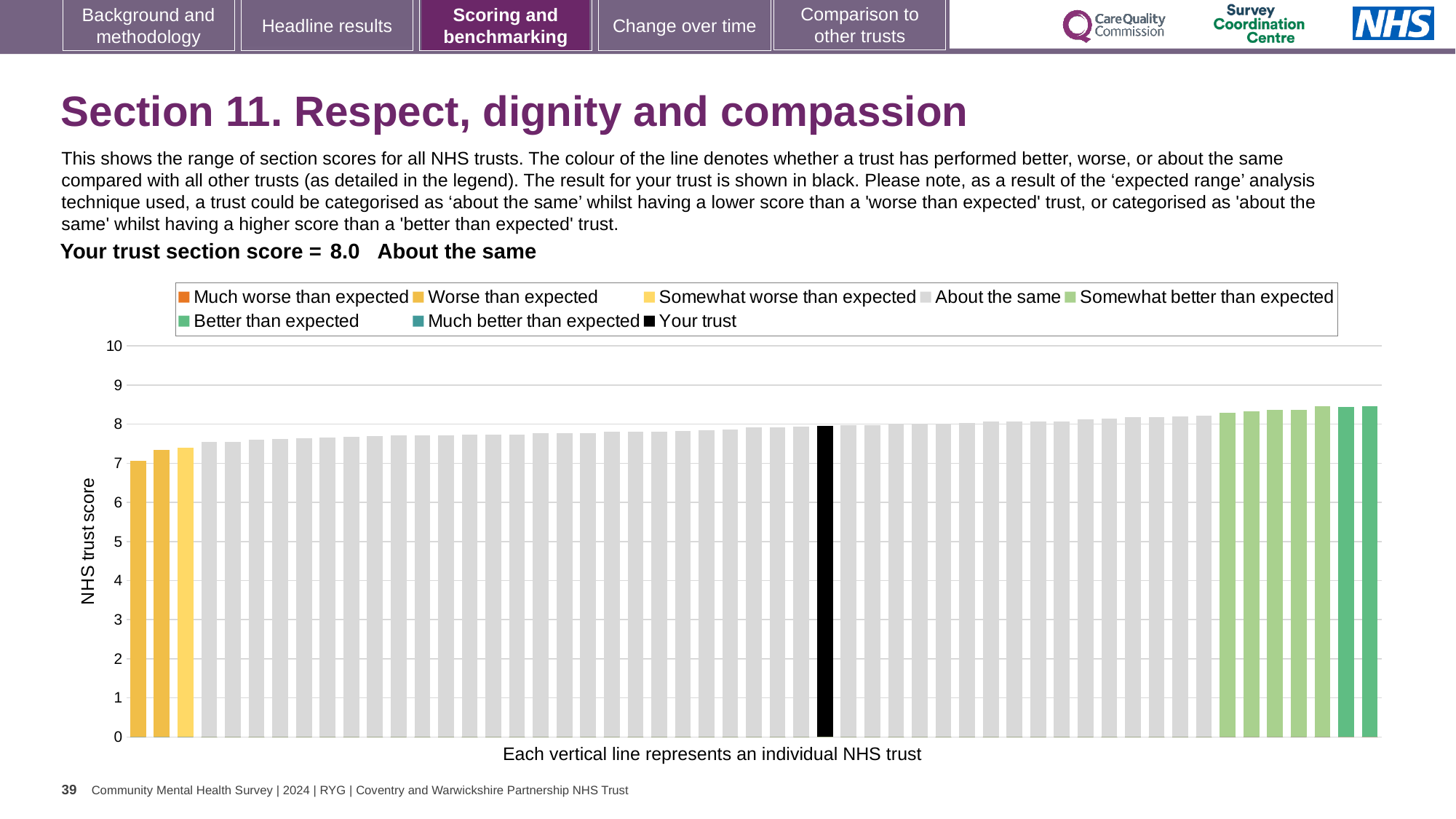
What is the label on the vertical axis of the chart? NHS trust score Is the value of the lowest bar on the chart greater or less than 8? less Which legend category does the lowest bar on the chart belong to? Worse than expected What is the section score for your trust? 8.0 How many entries does the chart legend list? 8 Is the value of the highest bar on the chart greater or less than 8? greater What kind of chart is shown on the slide? bar chart Which performance category is your trust placed in for this section? About the same Is the value of the black 'Your trust' bar greater or less than 7? greater Which legend category does the highest bar on the chart belong to? Better than expected Do the bar values rise or fall from left to right along the x axis? rise